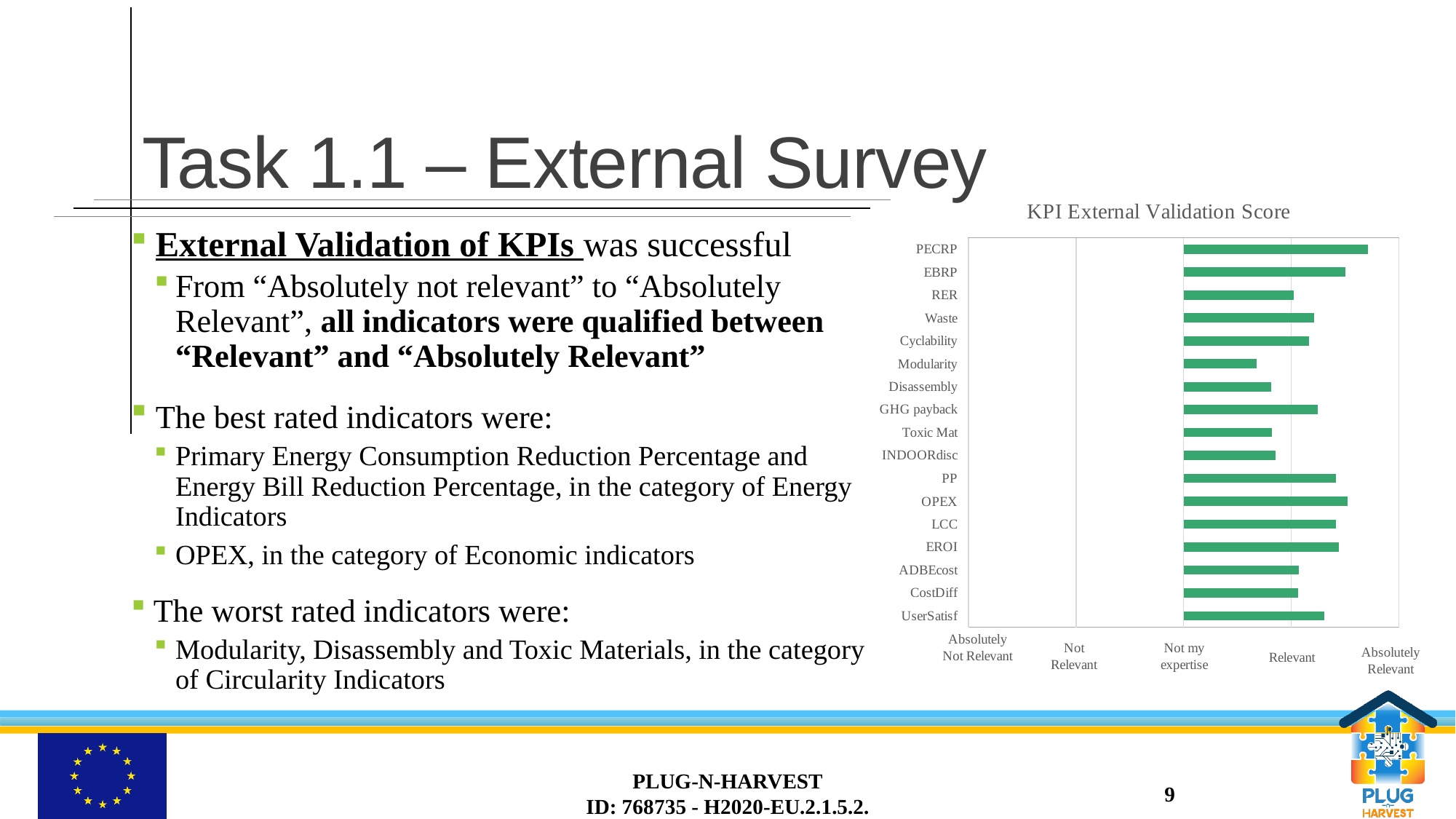
Which KPI has the shortest bar in the chart? Modularity Does the bar for Modularity reach the 'Relevant' tick on the x axis? No Which KPI has the longest bar in the chart? PECRP How many KPI categories are plotted in the chart? 17 What type of chart is shown on the slide? Bar chart Which has the longer bar, OPEX or Disassembly? OPEX How many labels are shown on the x axis of the chart? 5 Which has the longer bar, UserSatisf or RER? UserSatisf Does the bar for PECRP extend past the 'Relevant' tick on the x axis? Yes Which has the longer bar, EBRP or Toxic Mat? EBRP Which KPI is listed at the bottom of the chart's category axis? UserSatisf What is the title of the chart? KPI External Validation Score